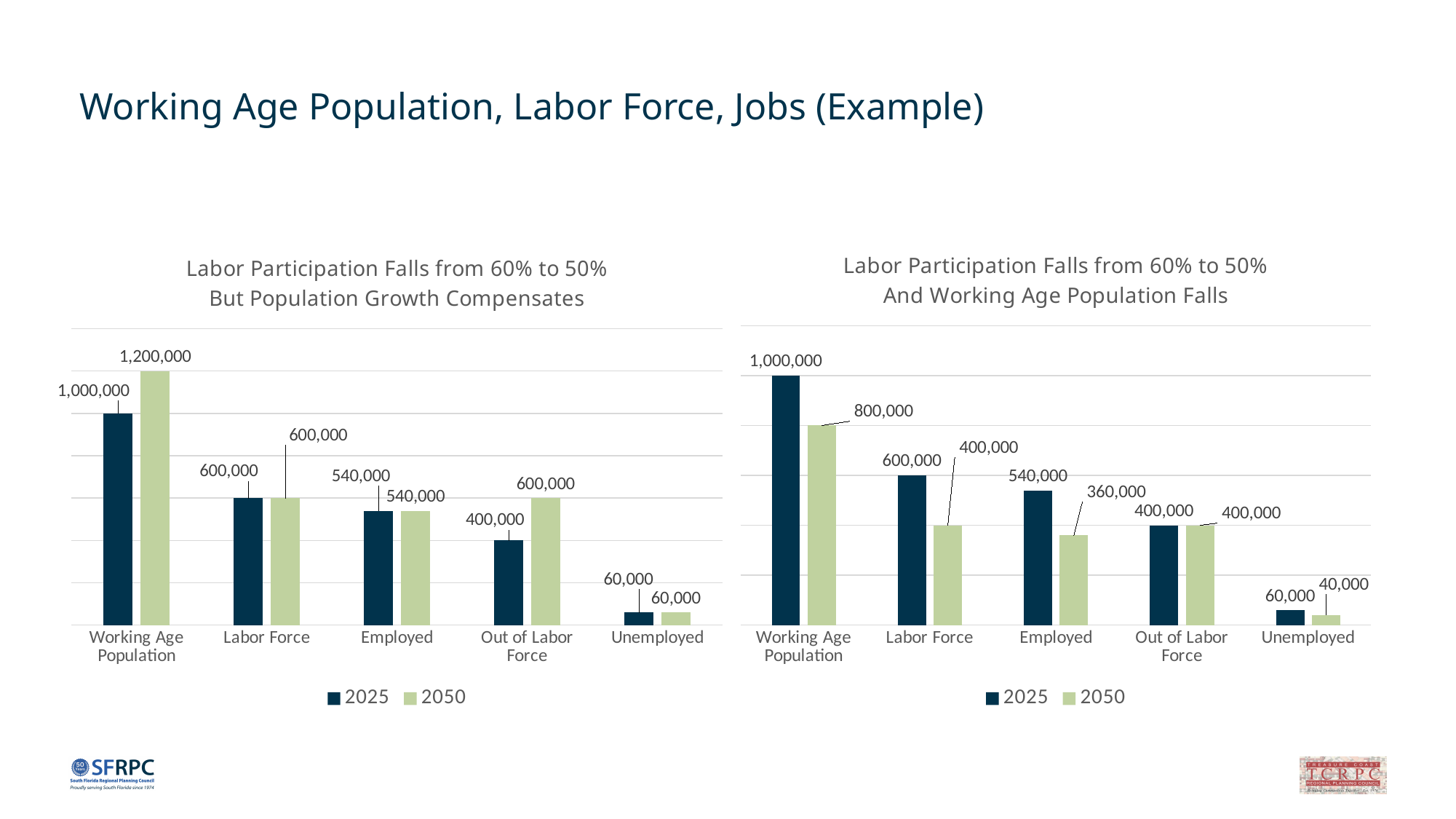
In the right chart ('Labor Participation Falls from 60% to 50% And Working Age Population Falls'), what is the 2050 value for Labor Force? 400,000 In the right chart, which is larger for Employed: the 2025 value or the 2050 value? 2025 In the left chart ('Labor Participation Falls from 60% to 50% But Population Growth Compensates'), what is the 2050 value for Working Age Population? 1,200,000 What are the two series named in the legend of the left chart? 2025 and 2050 In the right chart, what is the difference between the 2025 and 2050 values for Working Age Population? 200,000 In the left chart, which category has the highest 2050 value? Working Age Population What type of chart is the left chart? Bar chart In the right chart, which category has the lowest 2050 value? Unemployed In the left chart, what is the difference between the 2050 and 2025 values for Out of Labor Force? 200,000 How many categories are shown on the x axis of the left chart? 5 How many series does the legend of the right chart list? 2 In the right chart, what is the 2050 value for Employed? 360,000